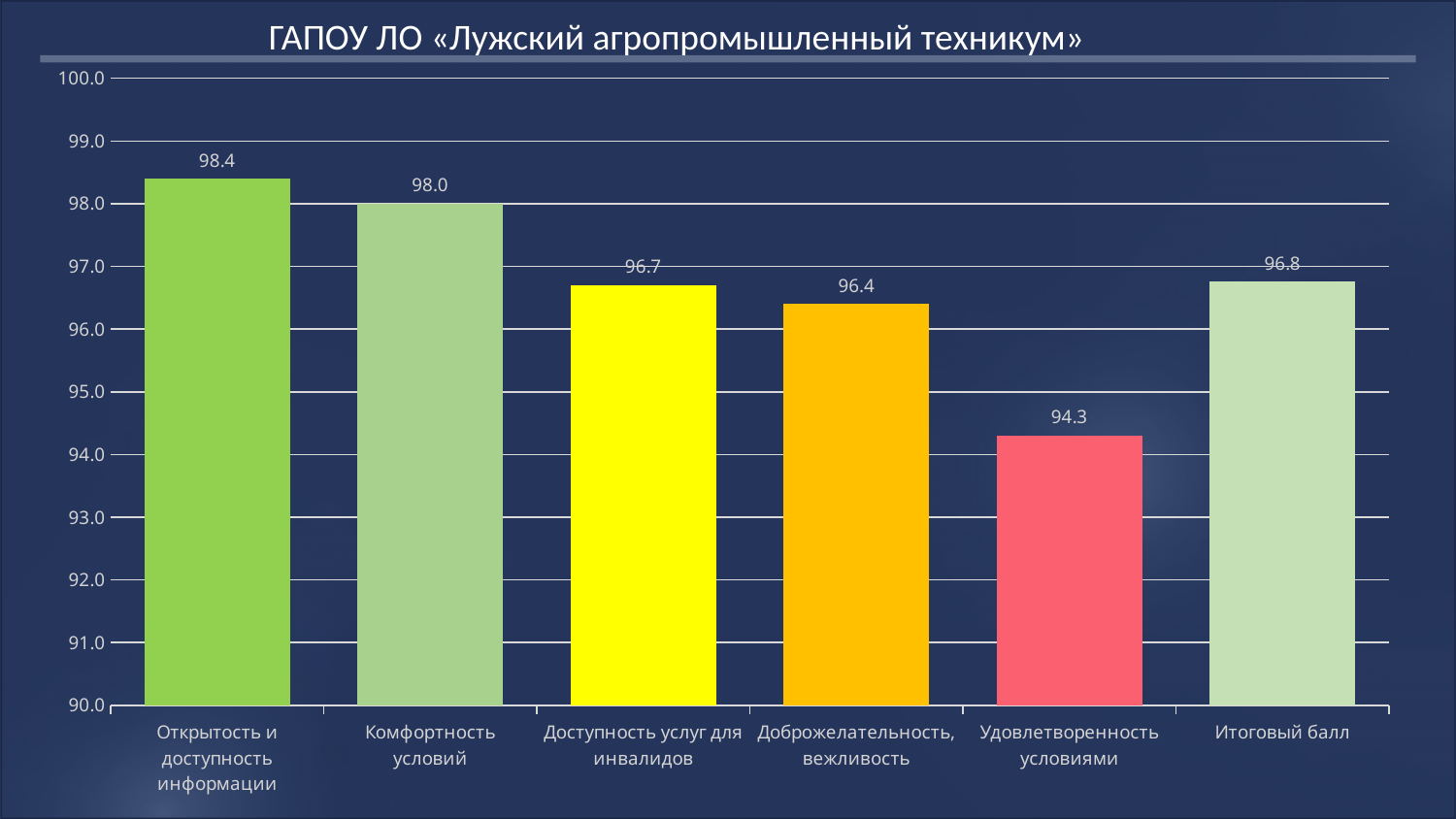
Which is larger: «Доступность услуг для инвалидов» or «Доброжелательность, вежливость»? Доступность услуг для инвалидов Is the value for «Доброжелательность, вежливость» greater or less than 97.0? less What is the value for «Удовлетворенность условиями»? 94.3 Which category has the highest value? Открытость и доступность информации What is the value for «Итоговый балл»? 96.8 How many categories are shown on the chart? 6 What is the title of the chart? ГАПОУ ЛО «Лужский агропромышленный техникум» What kind of chart is shown on the slide? bar chart What is the difference between «Комфортность условий» and «Удовлетворенность условиями»? 3.7 What is the value for «Открытость и доступность информации»? 98.4 What colour is the bar for «Удовлетворенность условиями»? red (pink) Which category has the lowest value? Удовлетворенность условиями